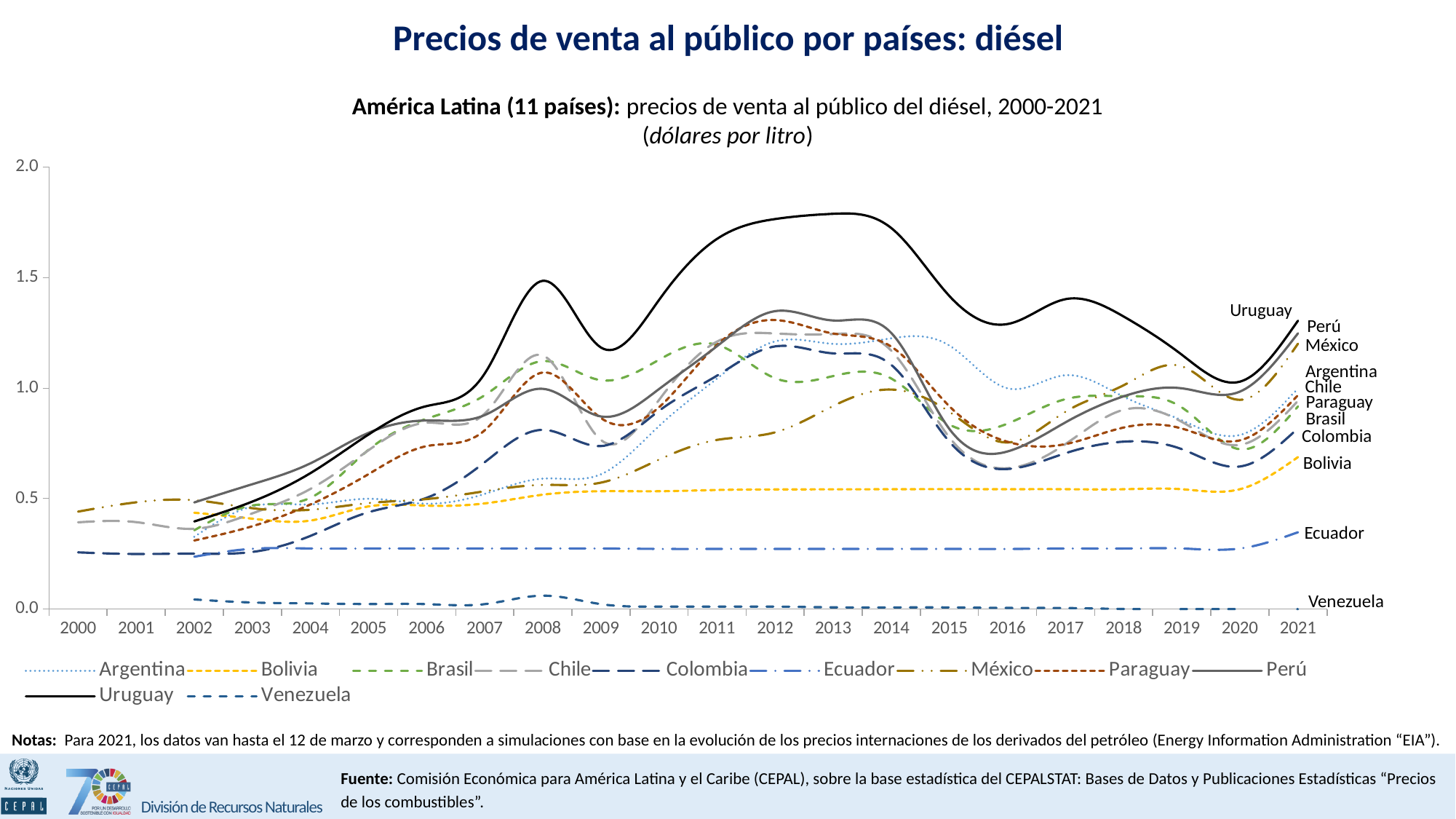
In what unit are the diesel prices expressed, according to the chart subtitle? dólares por litro Is the value for Ecuador in 2010 greater or less than 0.5? less Does the Uruguay line rise or fall between 2013 and 2016? Fall Which country has the highest diesel price in 2021? Uruguay Is the value for Uruguay in 2013 greater or less than 1.5? greater What kind of chart is shown on the slide? Line chart How many series (countries) does the legend list? 11 Is the value for Bolivia in 2015 greater or less than 1.0? less Which country has the highest diesel price in 2013? Uruguay How many years are shown along the x axis? 22 Which is larger in 2012, the value for Uruguay or the value for Perú? Uruguay Which country has the lowest diesel price in 2021? Venezuela